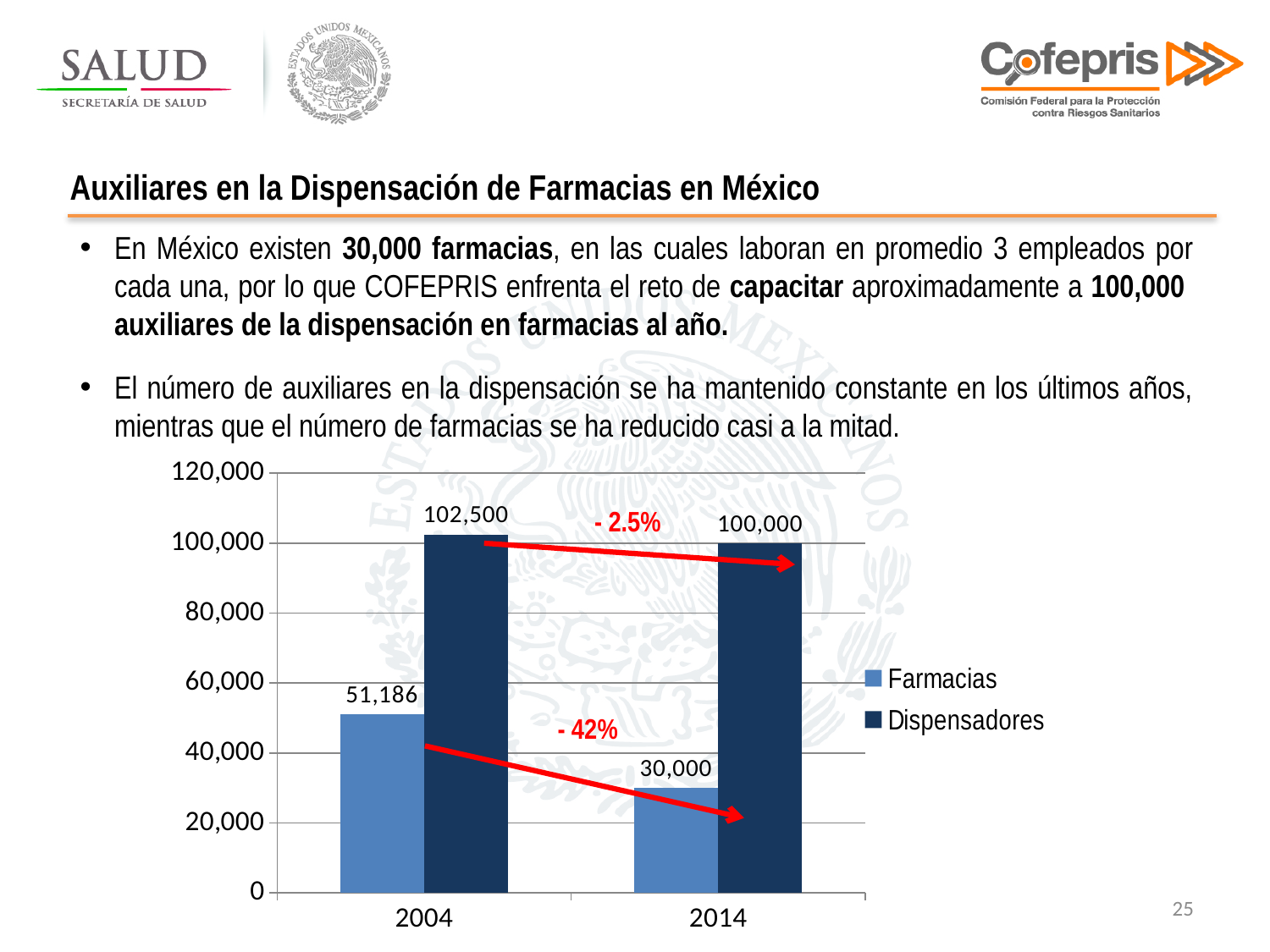
How many series does the legend list? 2 How many years are shown on the x axis? 2 What is the value for Dispensadores in 2014? 100,000 What kind of chart is shown on the slide? Bar chart What percentage change is annotated for Farmacias between 2004 and 2014? - 42% What is the difference between the Dispensadores values in 2004 and 2014? 2,500 What is the difference between the Farmacias values in 2004 and 2014? 21,186 What is the value for Farmacias in 2014? 30,000 What is the value for Farmacias in 2004? 51,186 Which is larger in 2014, Farmacias or Dispensadores? Dispensadores Which year has the higher value for Farmacias? 2004 What is the value for Dispensadores in 2004? 102,500